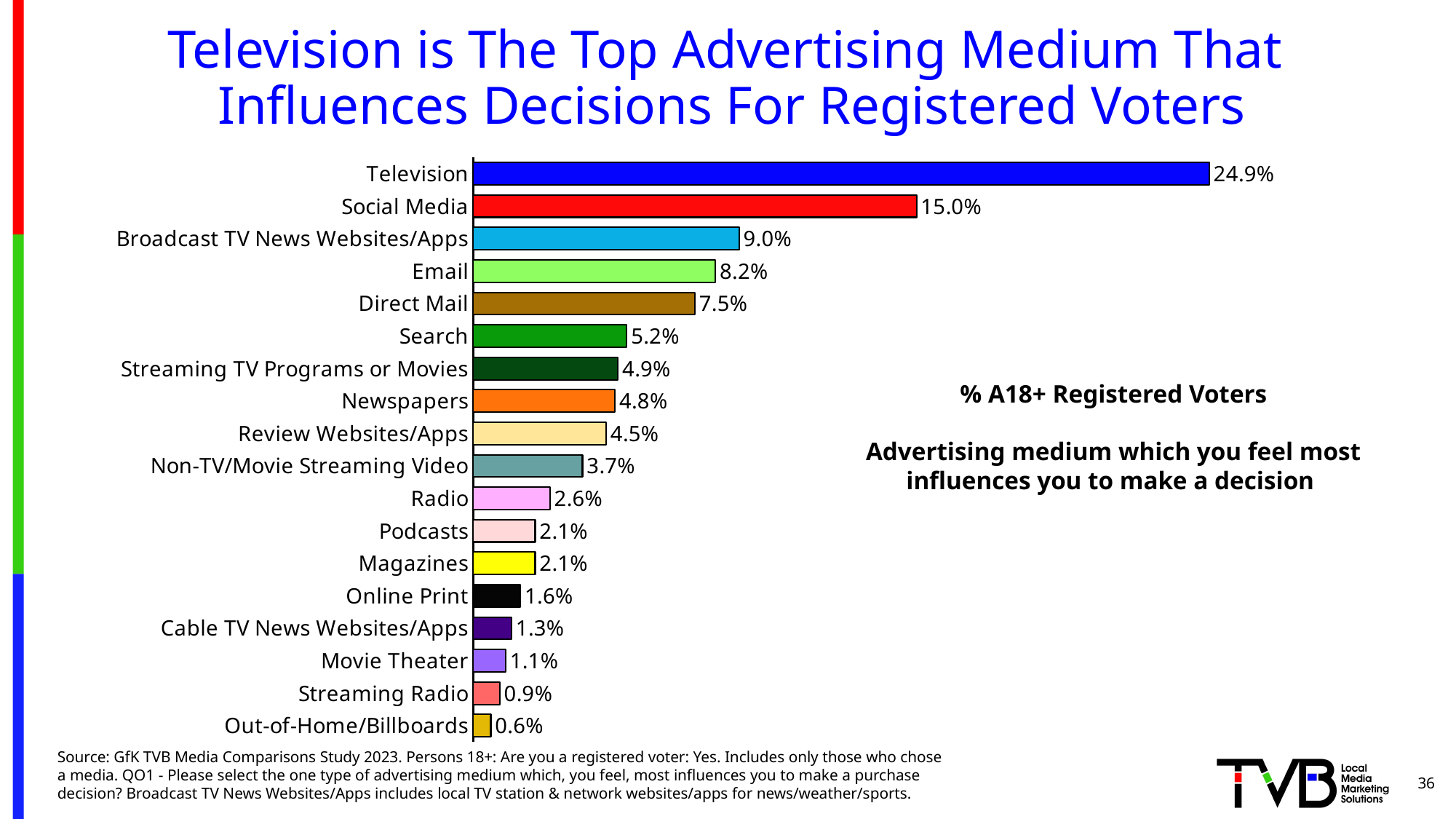
What colour is the bar for Magazines? Yellow Which advertising medium has the highest value on the chart? Television Which advertising medium has the lowest value on the chart? Out-of-Home/Billboards What is the difference between the values for Television and Social Media? 9.9% What percentage of registered voters chose Television as the advertising medium that most influences their decisions? 24.9% What is the value shown for Social Media? 15.0% How many advertising media categories are shown on the chart? 18 What type of chart is shown on the slide? Bar chart Which has a larger value, Search or Newspapers? Search What is the value shown for Out-of-Home/Billboards? 0.6% What is the value shown for Direct Mail? 7.5% What is the difference between the values for Email and Direct Mail? 0.7%